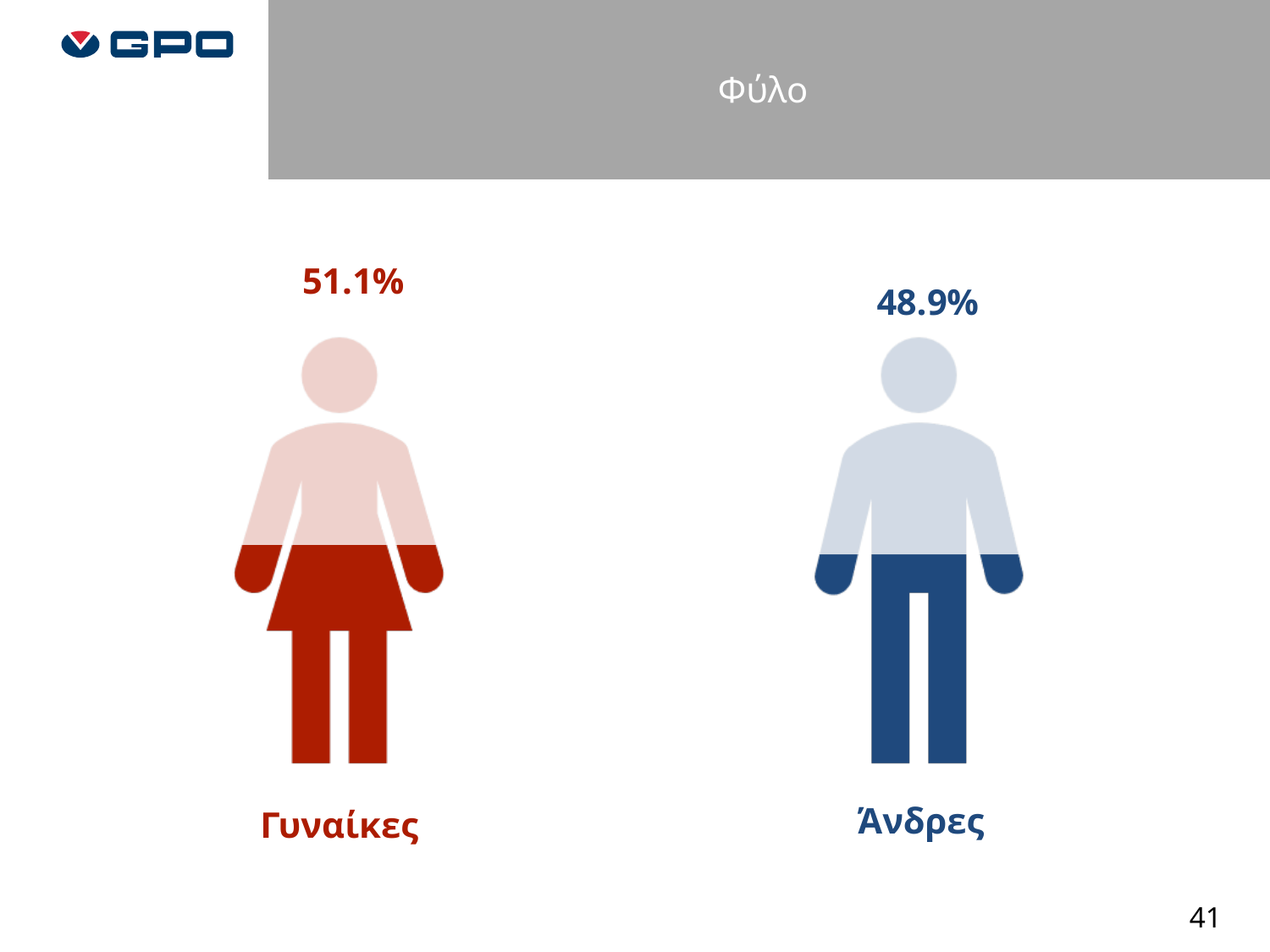
What do the two percentages add up to? 100% What colour is used for the Γυναίκες figure? Red Is the value for Άνδρες greater or less than 50%? less Which category has the higher percentage, Γυναίκες or Άνδρες? Γυναίκες What is the title of the chart? Φύλο What percentage is shown for Γυναίκες? 51.1% Which category has the lowest percentage? Άνδρες What kind of chart is shown on the slide? Pictogram (human figure icons) What percentage is shown for Άνδρες? 48.9% How many categories are shown on the slide? 2 What is the difference in percentage points between Γυναίκες and Άνδρες? 2.2 percentage points Which category has the highest percentage? Γυναίκες